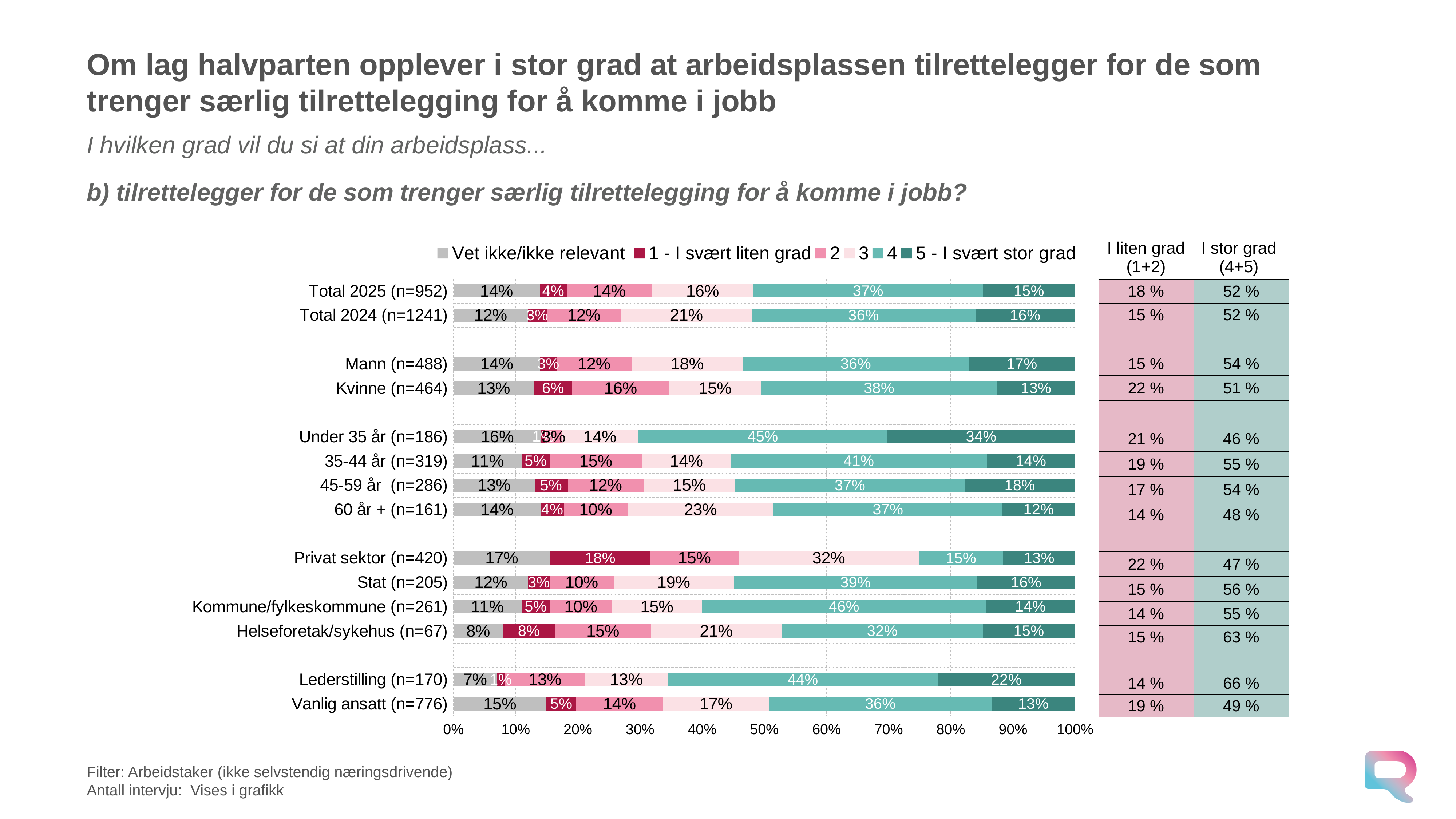
Which category has the lowest "Vet ikke/ikke relevant" share? Lederstilling (n=170) What percentage of Under 35 år (n=186) respondents answered "5 - I svært stor grad"? 34% Which has a larger "4" share: Under 35 år (n=186) or 35-44 år (n=319)? Under 35 år (n=186) How many percentage points higher is the "3" share for Privat sektor (n=420) than for Total 2025 (n=952)? 16 percentage points Which category has the highest "1 - I svært liten grad" share? Privat sektor (n=420) Which category has the highest "5 - I svært stor grad" share? Under 35 år (n=186) What is the "Vet ikke/ikke relevant" value for Lederstilling (n=170)? 7% What percentage of Kommune/fylkeskommune (n=261) respondents answered "4"? 46% What kind of chart is shown on the slide? Stacked horizontal bar chart How many series does the legend list? 6 What is the "1 - I svært liten grad" value for Privat sektor (n=420)? 18% How many categories (bars) are shown in the chart? 14